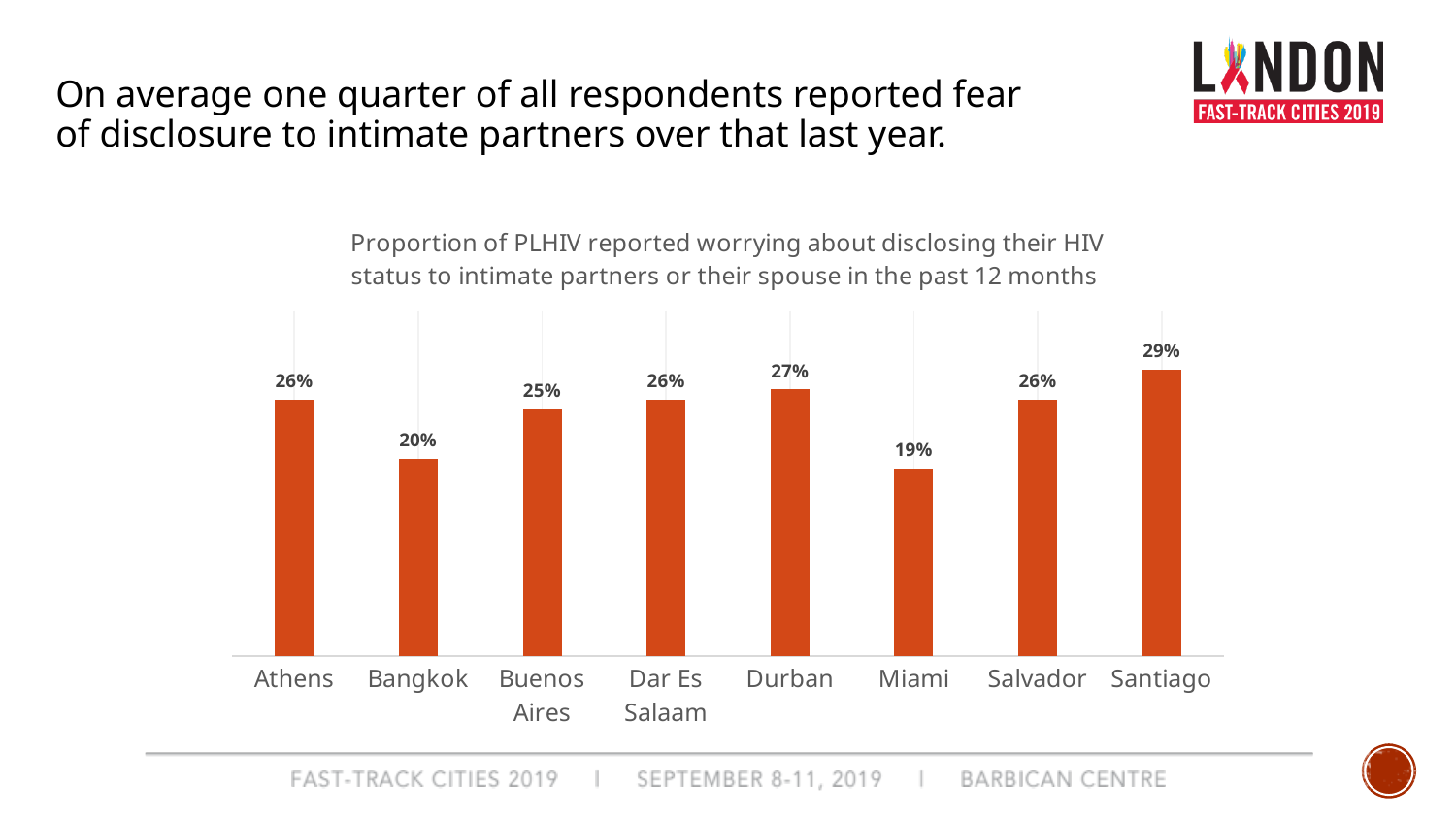
What is the value for Bangkok? 20% What is the value for Miami? 19% What kind of chart is shown on the slide? Bar chart What is the difference between the values for Durban and Buenos Aires? 2% What is the difference between the values for Santiago and Miami? 10% How many cities are shown on the chart? 8 What is the value for Athens? 26% What is the value for Santiago? 29% Which is larger, the value for Durban or the value for Bangkok? Durban What is the title of the chart? Proportion of PLHIV reported worrying about disclosing their HIV status to intimate partners or their spouse in the past 12 months Which city has the highest value? Santiago Which city has the lowest value? Miami